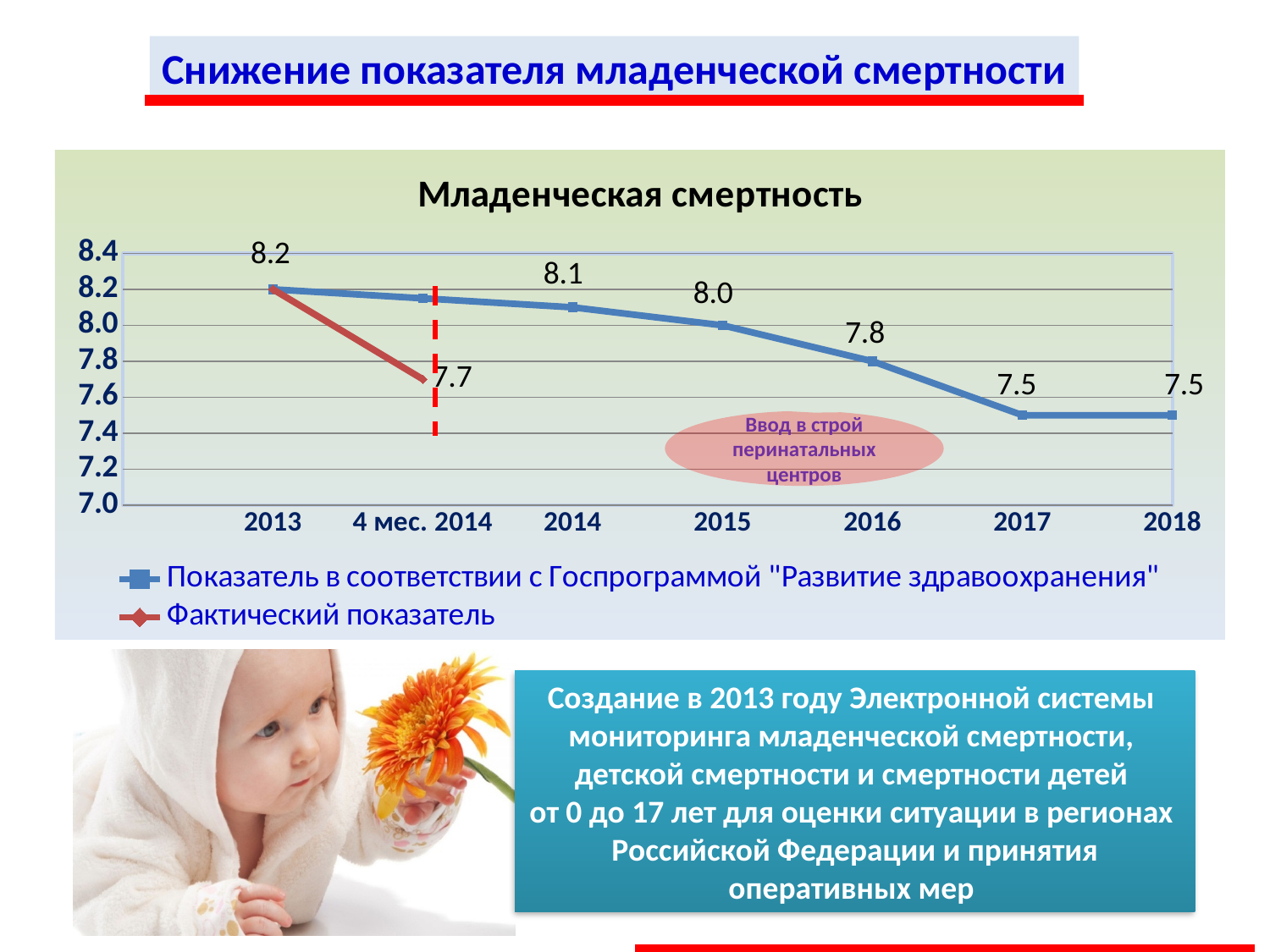
How many categories are shown on the x axis? 7 What is the difference between the 2013 and 2018 values of the series "Показатель в соответствии с Госпрограммой "Развитие здравоохранения""? 0.7 What is the value of the series "Показатель в соответствии с Госпрограммой "Развитие здравоохранения"" for 2013? 8.2 What is the value of the series "Фактический показатель" for "4 мес. 2014"? 7.7 Does the series "Показатель в соответствии с Госпрограммой "Развитие здравоохранения"" rise or fall from 2013 to 2018? fall Which is larger for "4 мес. 2014": the value of "Показатель в соответствии с Госпрограммой "Развитие здравоохранения"" or the value of "Фактический показатель"? Показатель в соответствии с Госпрограммой "Развитие здравоохранения" What is the value of the series "Показатель в соответствии с Госпрограммой "Развитие здравоохранения"" for 2016? 7.8 What is the value of the series "Показатель в соответствии с Госпрограммой "Развитие здравоохранения"" for 2018? 7.5 Is the value of the series "Показатель в соответствии с Госпрограммой "Развитие здравоохранения"" for "4 мес. 2014" greater or less than 8.0? greater What kind of chart is shown on the slide? line chart What is the title of the chart? Младенческая смертность How many series does the chart legend list? 2